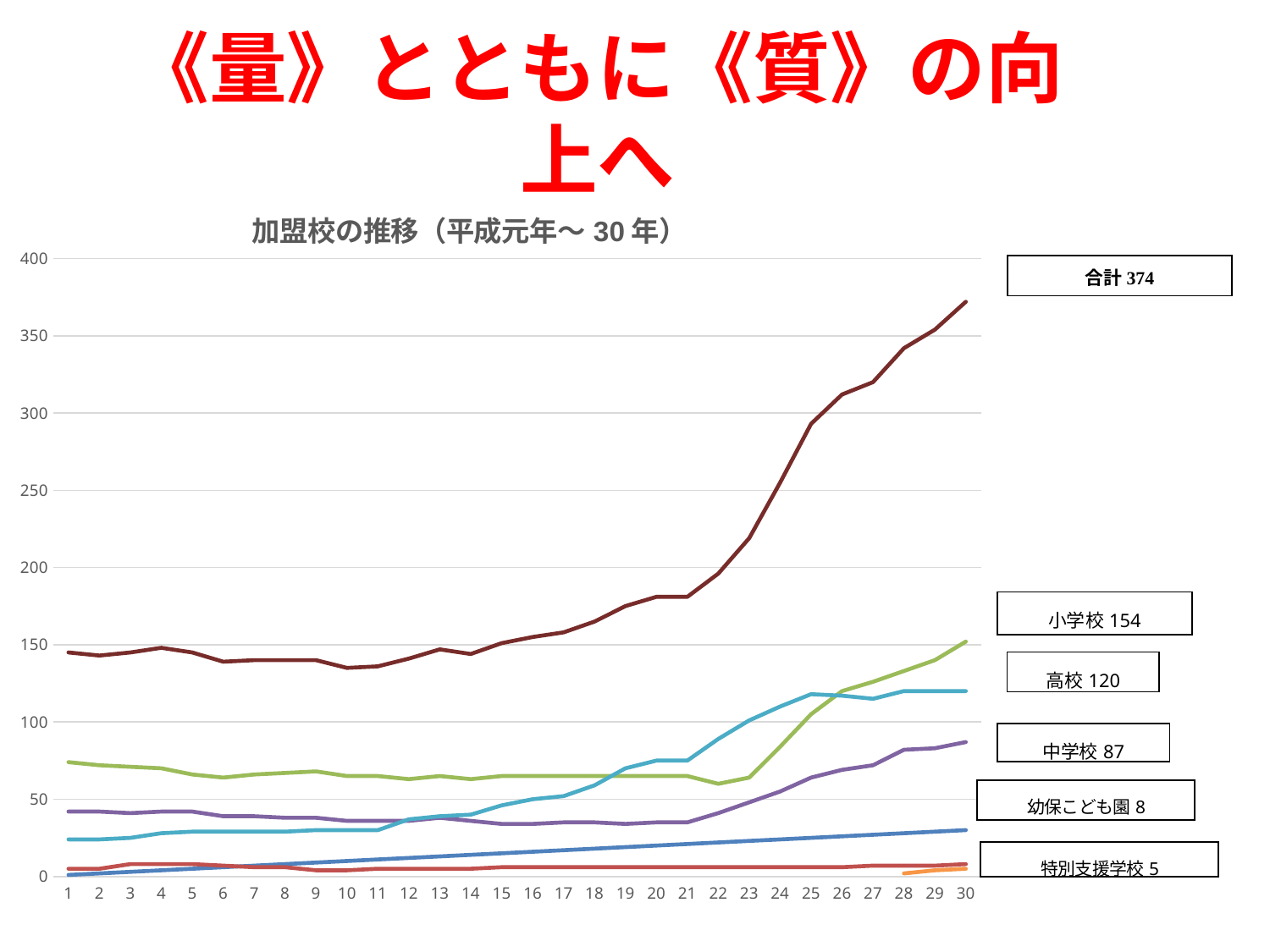
Which series has the highest value at year 30? 合計 What is the difference between 小学校 and 高校 at year 30? 34 Which is larger at year 30, 高校 or 中学校? 高校 What is the title of the chart? 加盟校の推移（平成元年～30年） What is the value of 合計 at year 30? 374 How many years are shown on the x axis? 30 What is the value of 小学校 at year 30? 154 What kind of chart is shown on the slide? line chart What is the value of 中学校 at year 30? 87 What is the value of 高校 at year 30? 120 Does the 合計 line rise or fall overall from year 1 to year 30? rise Is the value of 合計 at year 25 greater or less than 250? greater